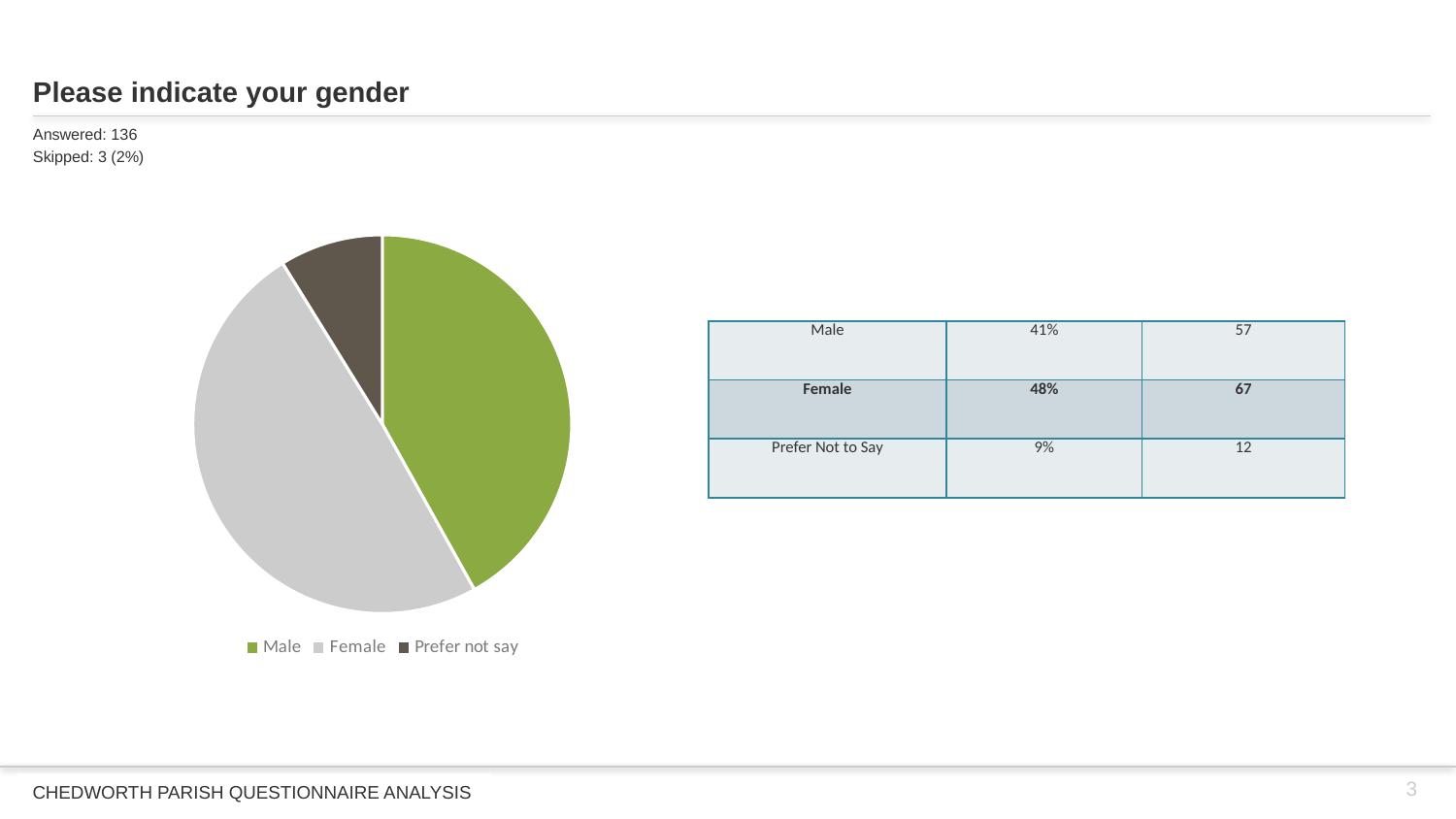
How many slices does the pie chart have? 3 According to the table next to the pie chart, what percentage of respondents are Female? 48% Which category has the largest slice of the pie chart? Female Using the counts in the table, how many more Female respondents are there than Male respondents? 10 What colour is the Male slice in the pie chart? green According to the table next to the pie chart, how many respondents answered Male? 57 According to the table next to the pie chart, how many respondents answered Prefer Not to Say? 12 Is the Male slice or the Female slice of the pie chart larger? Female How many entries does the pie chart's legend list? 3 According to the table next to the pie chart, what percentage of respondents are Male? 41% Which category has the smallest slice of the pie chart? Prefer not say What kind of chart is shown on the slide? pie chart